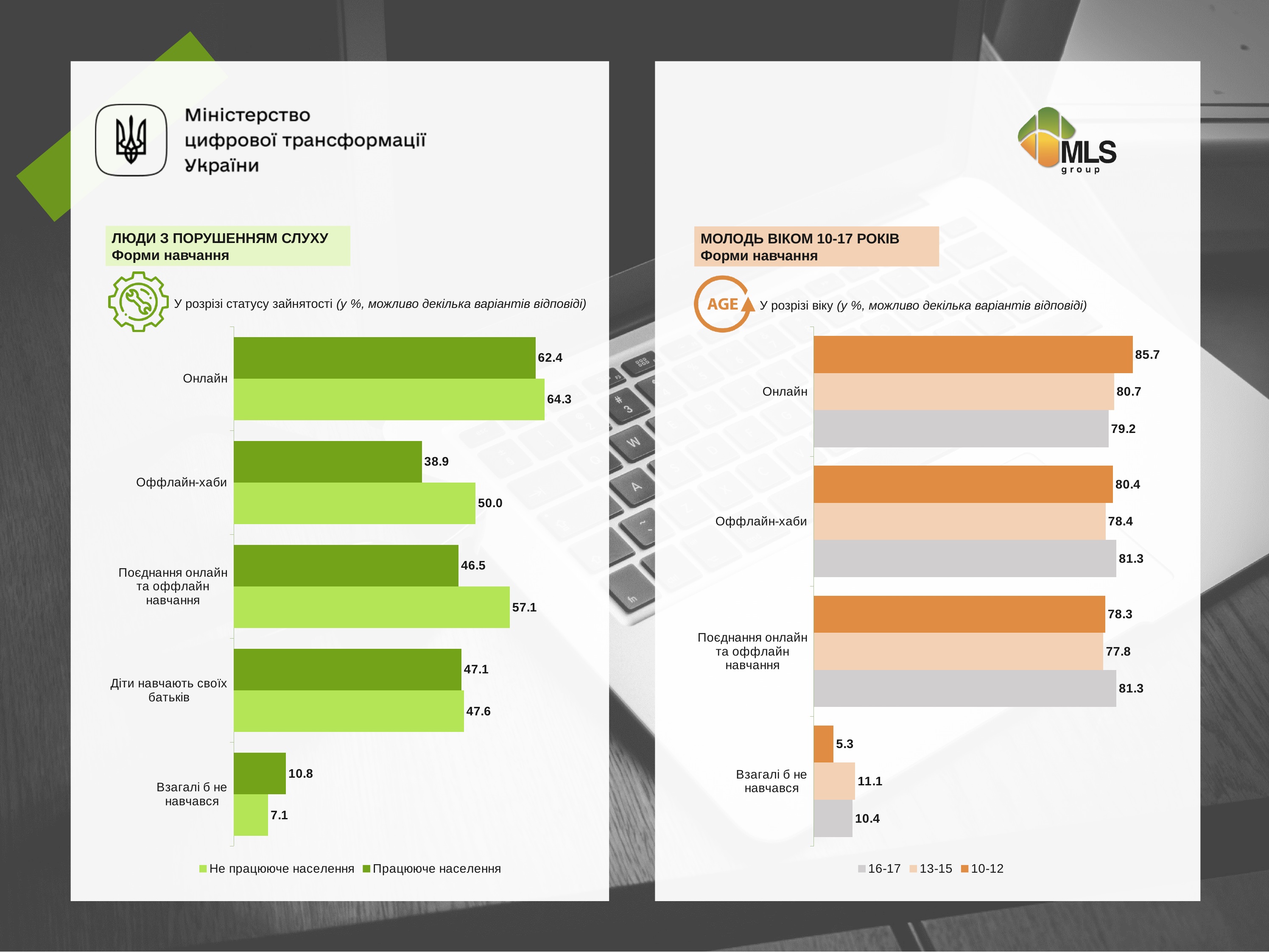
In the right chart (МОЛОДЬ ВІКОМ 10-17 РОКІВ), which is larger for Оффлайн-хаби: the 16-17 group or the 13-15 group? 16-17 In the right chart (МОЛОДЬ ВІКОМ 10-17 РОКІВ), what is the value for Онлайн for the 10-12 age group? 85.7 In the left chart (ЛЮДИ З ПОРУШЕННЯМ СЛУХУ), what is the value for Онлайн for Працююче населення? 62.4 In the left chart (ЛЮДИ З ПОРУШЕННЯМ СЛУХУ), what is the value for Оффлайн-хаби for Не працююче населення? 50.0 In the right chart (МОЛОДЬ ВІКОМ 10-17 РОКІВ), how many series does the legend list? 3 What type of chart is used on the right side of the slide (МОЛОДЬ ВІКОМ 10-17 РОКІВ)? Bar chart In the left chart (ЛЮДИ З ПОРУШЕННЯМ СЛУХУ), which category has the lowest value for Не працююче населення? Взагалі б не навчався In the left chart (ЛЮДИ З ПОРУШЕННЯМ СЛУХУ), what is the difference between Не працююче населення and Працююче населення for Поєднання онлайн та оффлайн навчання? 10.6 In the left chart (ЛЮДИ З ПОРУШЕННЯМ СЛУХУ), how many categories are shown? 5 In the right chart (МОЛОДЬ ВІКОМ 10-17 РОКІВ), what is the value for Взагалі б не навчався for the 13-15 age group? 11.1 In the left chart (ЛЮДИ З ПОРУШЕННЯМ СЛУХУ), how many series does the legend list? 2 In the right chart (МОЛОДЬ ВІКОМ 10-17 РОКІВ), which age group has the highest value for Онлайн? 10-12